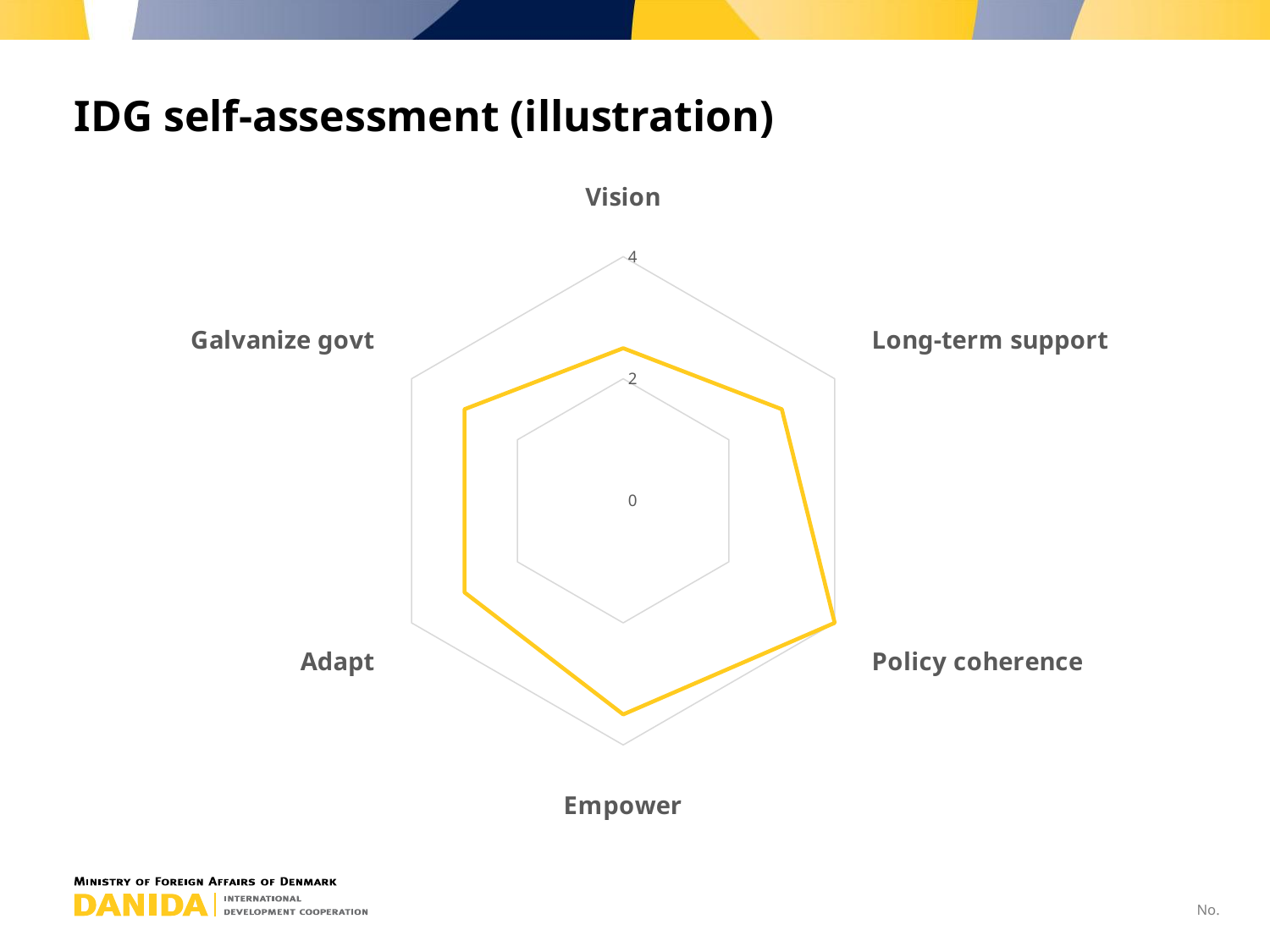
Which category has the lowest value on the radar chart? Vision Is the value for Vision greater or less than 4? less Is the value for Vision greater or less than 2? greater Which category has the highest value on the radar chart? Policy coherence What kind of chart is shown on the slide? Radar chart Which is larger, the value for Policy coherence or the value for Vision? Policy coherence How many categories (axes) does the radar chart have? 6 Is the value for Empower greater or less than 2? greater What is the title of the chart? IDG self-assessment (illustration) What is the maximum value shown on the chart's axis scale? 4